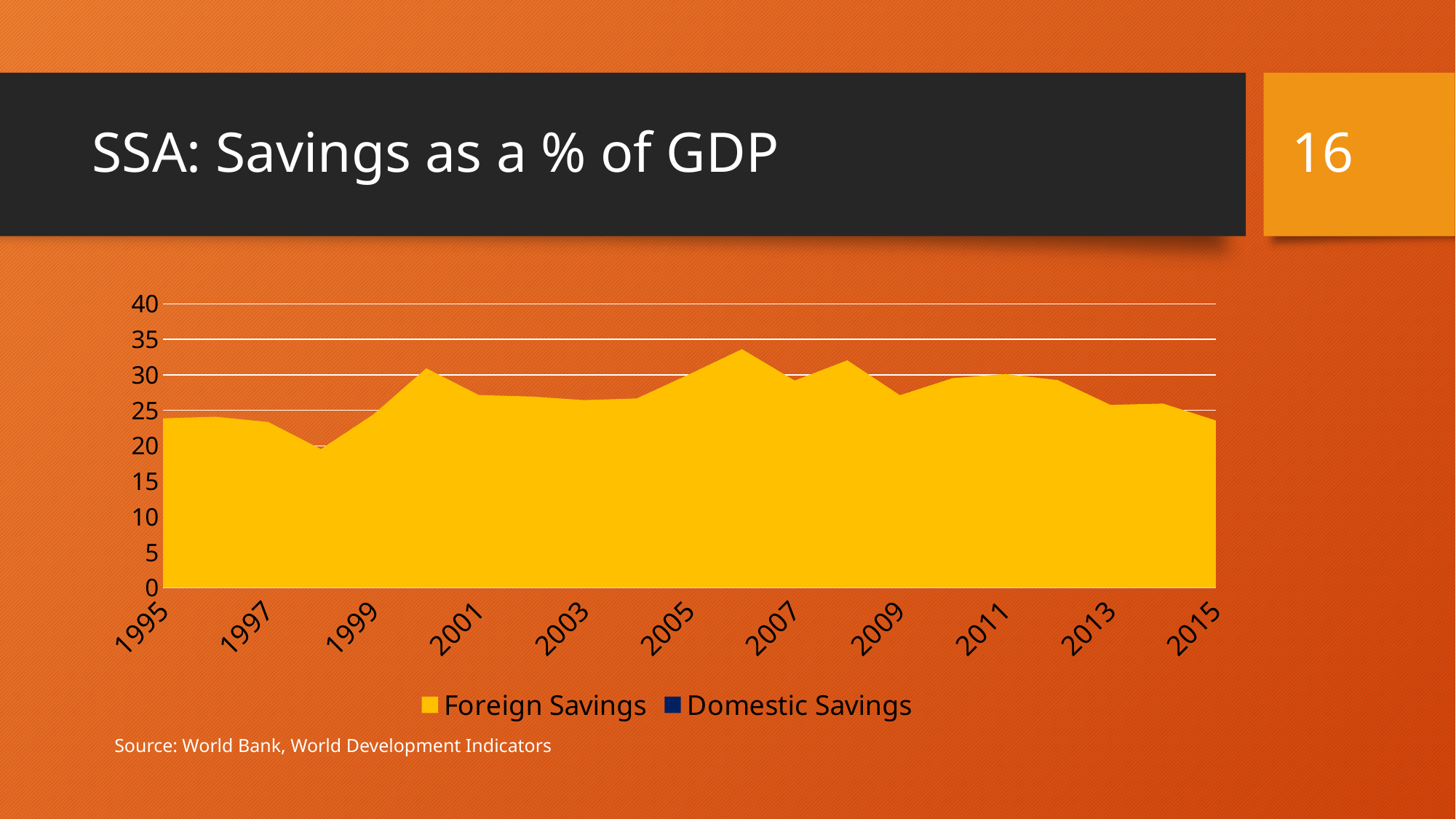
Is the value for Foreign Savings in 2006 greater or less than 30? greater In which year is Foreign Savings at its highest? 2006 What are the two series named in the legend? Foreign Savings and Domestic Savings Does Foreign Savings rise or fall between 2011 and 2015? Fall In which year is Foreign Savings at its lowest? 1998 Is the value for Foreign Savings in 2011 greater or less than 25? greater How many series does the legend list? 2 Does Foreign Savings rise or fall between 1998 and 2000? Rise Is the value for Foreign Savings in 2013 greater or less than 30? less What is the title of the chart on the slide? SSA: Savings as a % of GDP What kind of chart is shown on the slide? Area chart